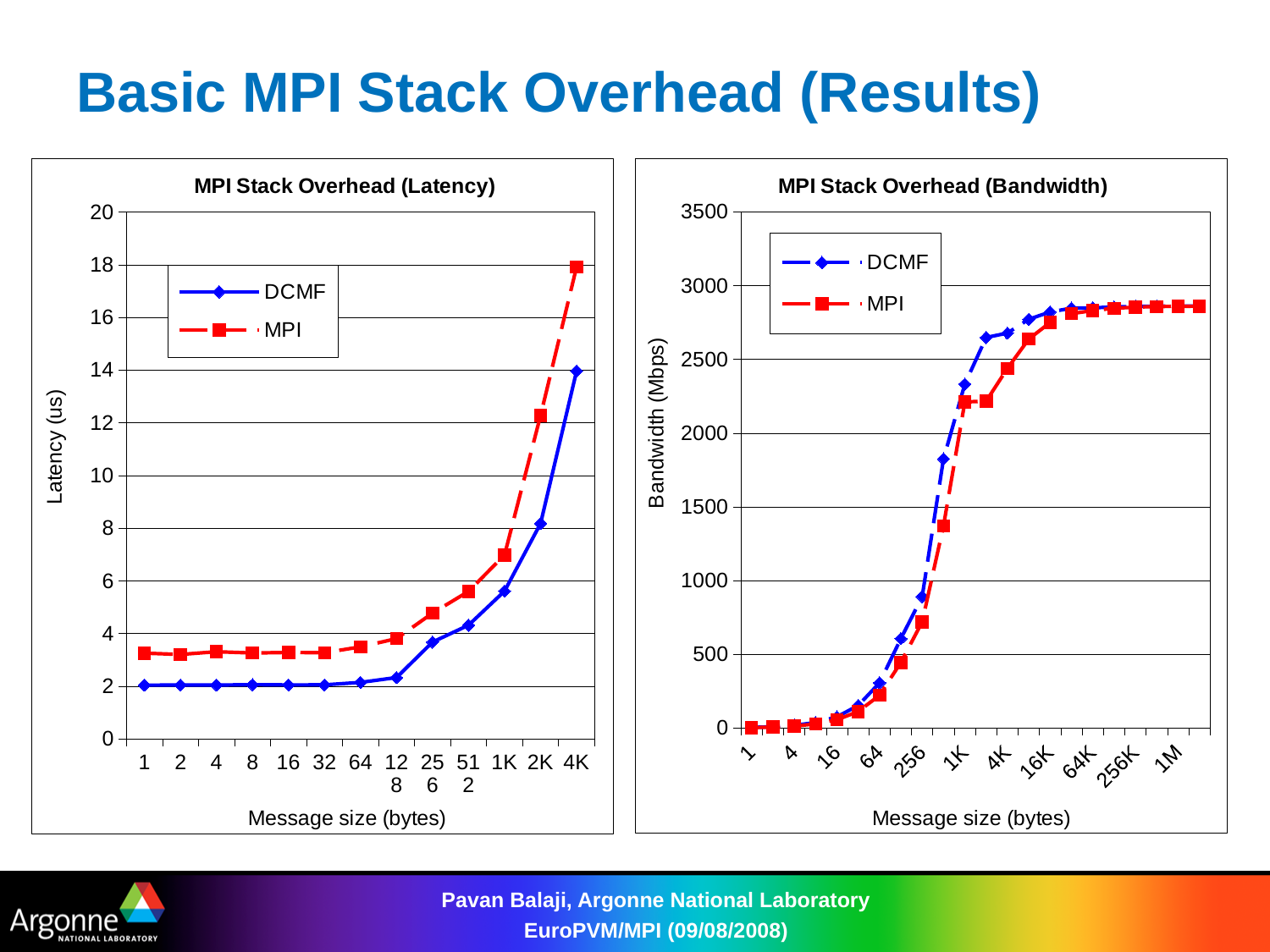
On the MPI Stack Overhead (Latency) chart, what kind of chart is it? line chart On the MPI Stack Overhead (Bandwidth) chart, is the DCMF bandwidth at 1M greater or less than 2500? greater On the MPI Stack Overhead (Latency) chart, is the DCMF latency at 4K greater or less than 16? less On the MPI Stack Overhead (Latency) chart, which series has the higher latency at 4K, DCMF or MPI? MPI On the MPI Stack Overhead (Latency) chart, do the latency values rise or fall as message size increases? rise On the MPI Stack Overhead (Bandwidth) chart, what is the label of the y axis? Bandwidth (Mbps) On the MPI Stack Overhead (Bandwidth) chart, which series has the higher bandwidth at 1K, DCMF or MPI? DCMF On the MPI Stack Overhead (Latency) chart, how many message sizes are plotted along the x axis? 13 On the MPI Stack Overhead (Bandwidth) chart, how many series does the legend list? 2 On the MPI Stack Overhead (Latency) chart, is the DCMF latency at message size 1 greater or less than 4? less